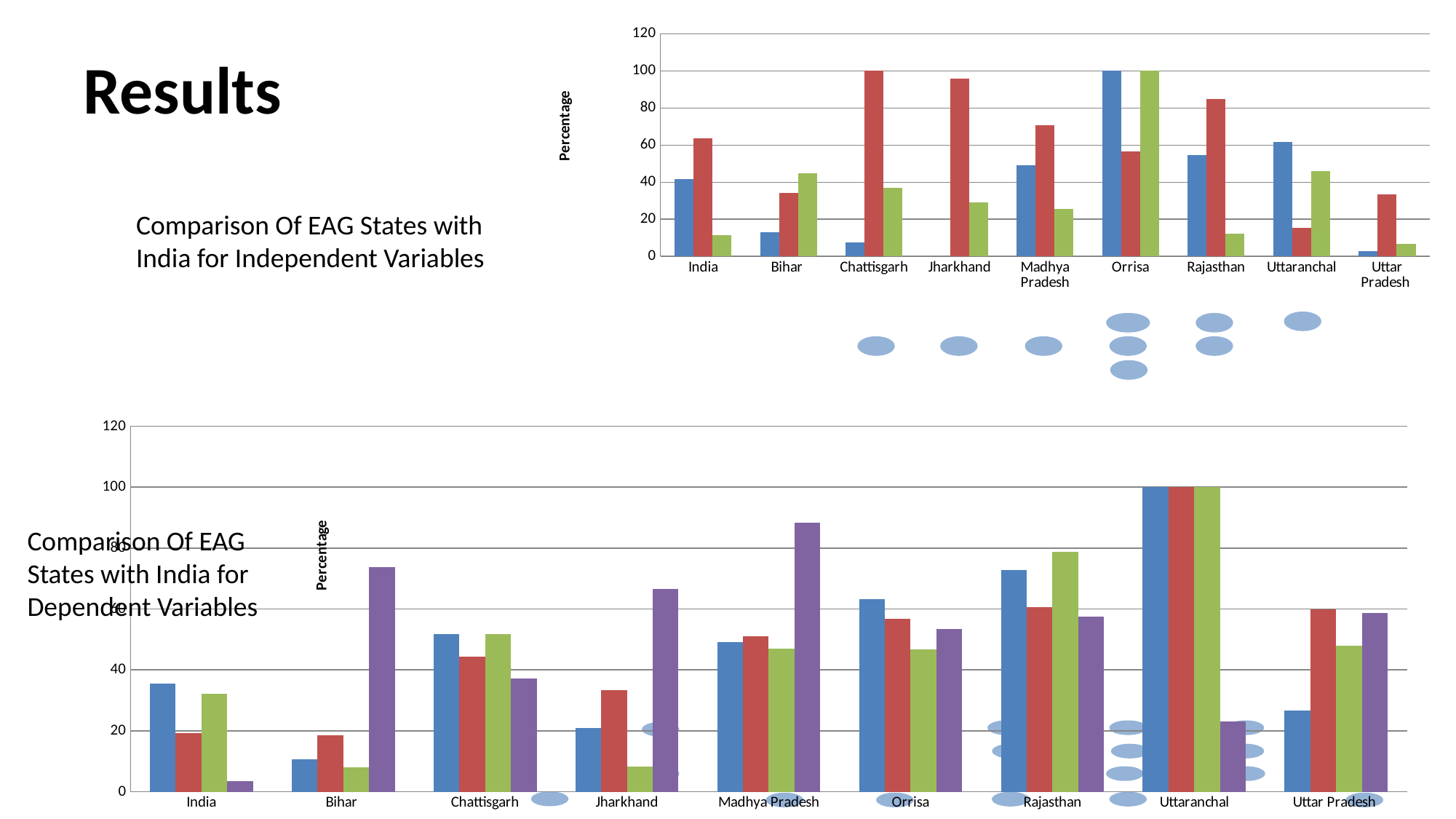
In the 'Comparison Of EAG States with India for Independent Variables' chart, is the blue bar for Bihar greater or less than 20? less In the 'Comparison Of EAG States with India for Dependent Variables' chart, is the purple bar for India greater or less than 20? less What is the label on the vertical axis of the 'Comparison Of EAG States with India for Dependent Variables' chart? Percentage In the 'Comparison Of EAG States with India for Dependent Variables' chart, what is the value of the blue bar for Uttaranchal? 100 How many states/categories are shown on the x axis of the 'Comparison Of EAG States with India for Independent Variables' chart? 9 In the 'Comparison Of EAG States with India for Independent Variables' chart, what is the value of the red bar for Chattisgarh? 100 In the 'Comparison Of EAG States with India for Dependent Variables' chart, which is larger: the blue bar for India or the blue bar for Bihar? India How many states/categories are shown on the x axis of the 'Comparison Of EAG States with India for Dependent Variables' chart? 9 In the 'Comparison Of EAG States with India for Independent Variables' chart, which is larger: the red bar for Rajasthan or the red bar for Uttaranchal? Rajasthan In the 'Comparison Of EAG States with India for Independent Variables' chart, which state has the tallest green bar? Orrisa In the 'Comparison Of EAG States with India for Independent Variables' chart, is the red bar for Jharkhand greater or less than 80? greater What type of chart is the 'Comparison Of EAG States with India for Independent Variables' chart? bar chart